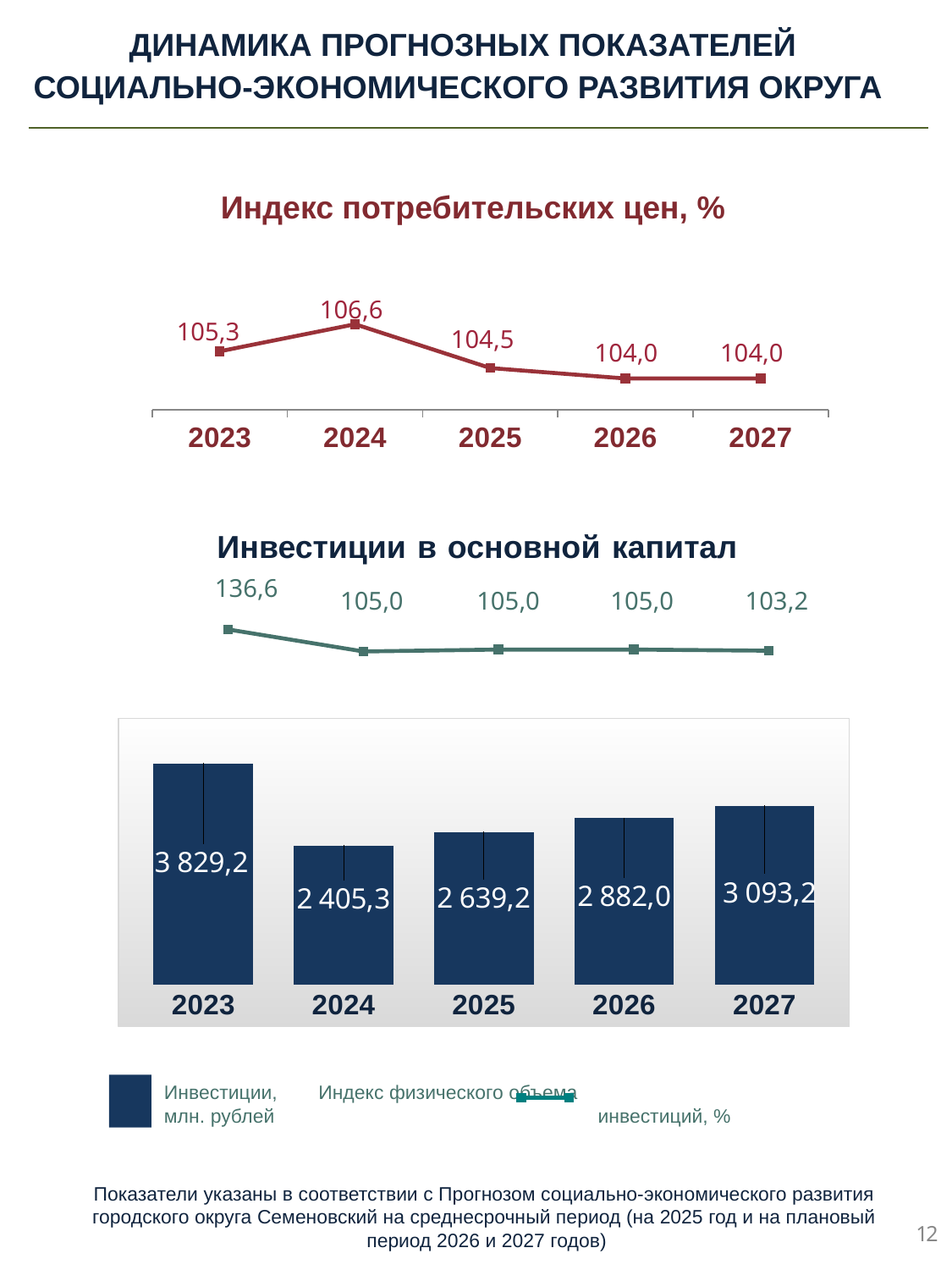
On the chart 'Индекс потребительских цен, %', what is the value for 2024? 106,6 On the chart 'Инвестиции в основной капитал', what is the difference between investments in 2023 and 2024 (млн. рублей)? 1 423,9 On the chart 'Инвестиции в основной капитал', which year has larger investments, 2026 or 2027? 2027 On the chart 'Индекс потребительских цен, %', how many years are plotted? 5 On the chart 'Инвестиции в основной капитал', what is the value of 'Индекс физического объема инвестиций, %' for 2027? 103,2 On the chart 'Инвестиции в основной капитал', which year has the lowest investments (млн. рублей)? 2024 On the chart 'Инвестиции в основной капитал', do investments (млн. рублей) rise or fall from 2024 to 2027? rise On the chart 'Индекс потребительских цен, %', which year has the highest value? 2024 On the chart 'Индекс потребительских цен, %', what is the difference between the 2024 and 2025 values? 2,1 On the chart 'Инвестиции в основной капитал', what kind of chart shows the investments in млн. рублей? bar chart On the chart 'Инвестиции в основной капитал', what is the value of investments (млн. рублей) for 2025? 2 639,2 On the chart 'Инвестиции в основной капитал', what is the value of 'Индекс физического объема инвестиций, %' for 2023? 136,6